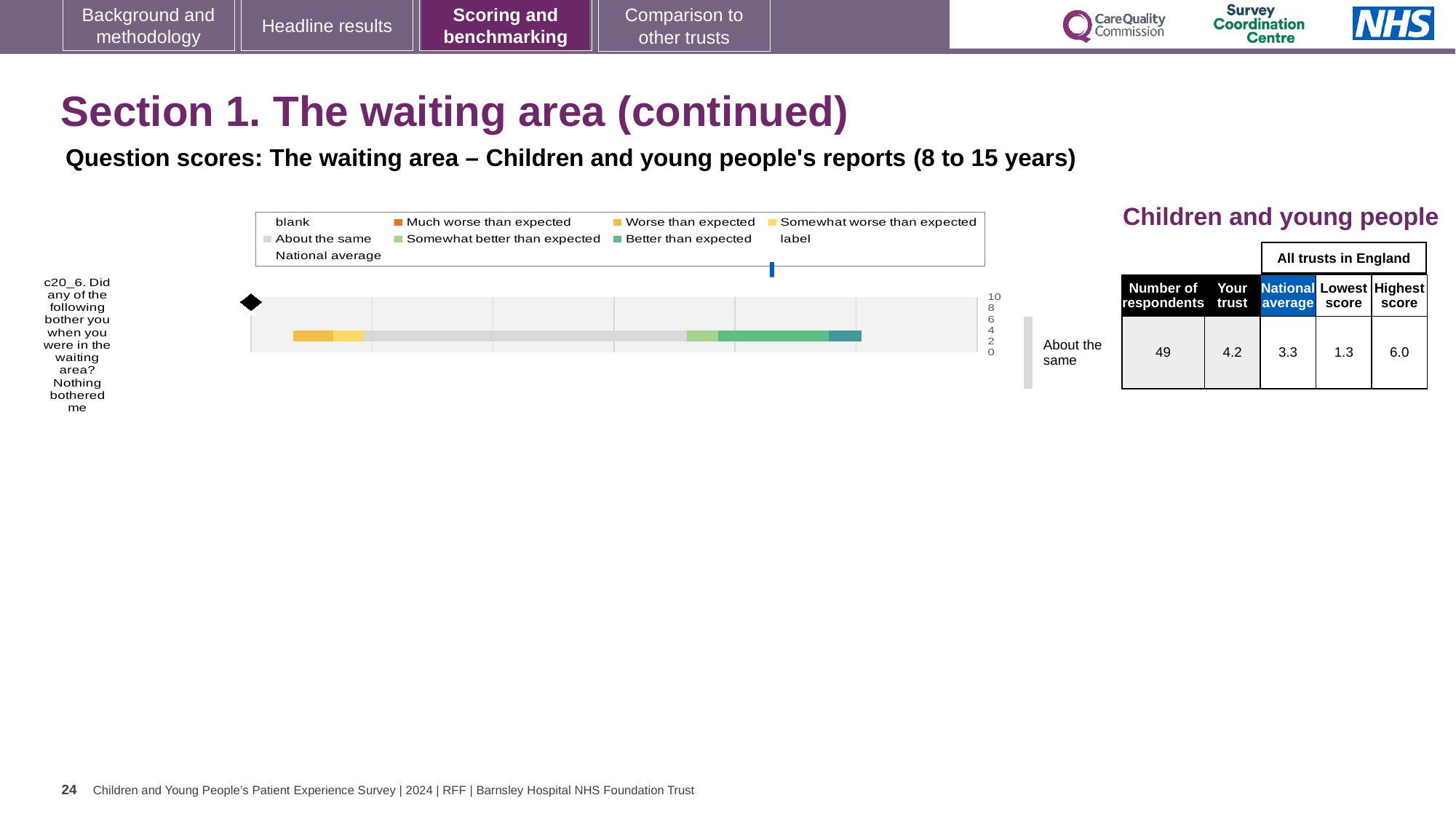
What is the highest value shown on the chart's axis? 10 In the table next to the chart, which is larger for question c20_6: the 'Your trust' score or the national average? Your trust What kind of chart is shown on the slide? bar chart In the table next to the chart, what is the national average score for question c20_6? 3.3 How many question categories are plotted in the chart? 1 Which question code is plotted in the chart? c20_6 In the table next to the chart, what is the lowest score among all trusts in England for question c20_6? 1.3 In the table next to the chart, what is the number of respondents for question c20_6? 49 In the table next to the chart, what is the 'Your trust' score for question c20_6? 4.2 How many entries does the chart legend list? 9 In the table next to the chart, what is the highest score among all trusts in England for question c20_6? 6.0 What benchmark label is shown next to the bar for question c20_6? About the same